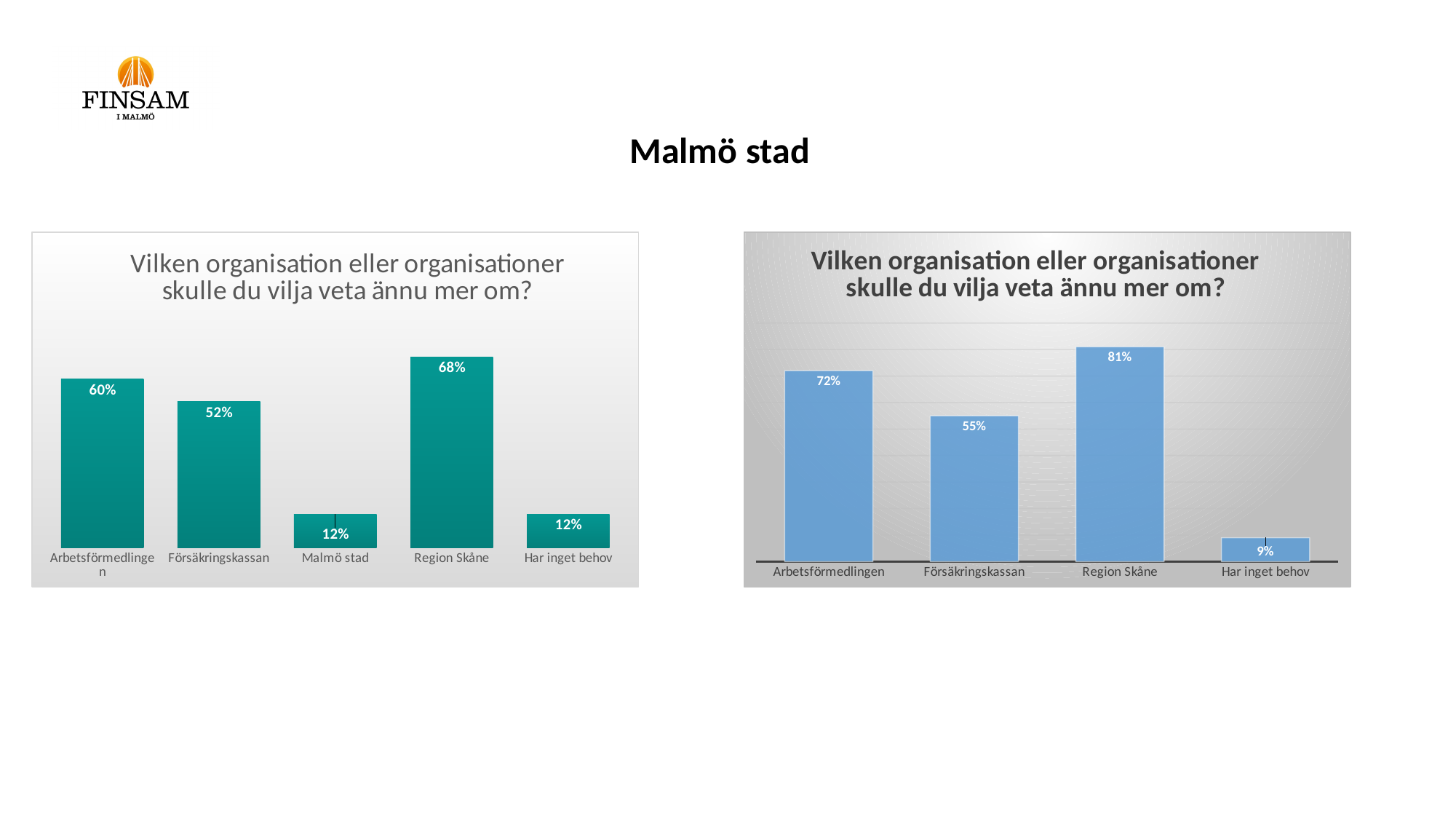
How many categories does the left chart show? 5 In the left chart, what is the value for Försäkringskassan? 52% In the left chart, what is the difference between Arbetsförmedlingen and Malmö stad? 48% In the right chart, what is the difference between Region Skåne and Försäkringskassan? 26% In the right chart, what is the value for Har inget behov? 9% How many categories does the right chart show? 4 In the left chart, what is the value for Region Skåne? 68% In the left chart, which is larger, Arbetsförmedlingen or Försäkringskassan? Arbetsförmedlingen What kind of chart is the right chart? Bar chart In the left chart, which category has the highest value? Region Skåne In the right chart, what is the value for Arbetsförmedlingen? 72% In the right chart, which category has the lowest value? Har inget behov